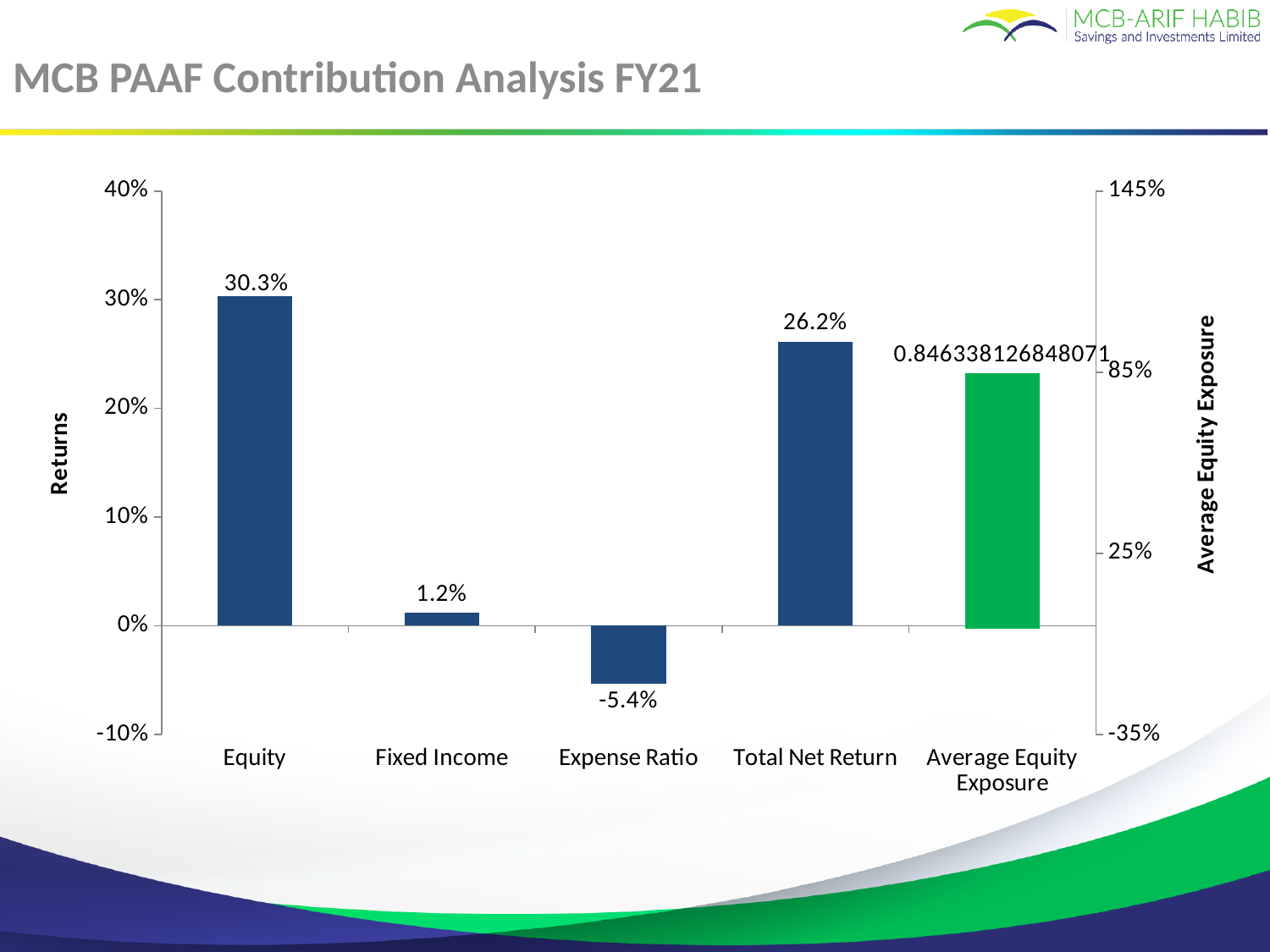
What data label is shown on the Average Equity Exposure bar? 0.846338126848071 Which category on the Returns axis has the highest value? Equity What is the value for Expense Ratio? -5.4% What is the difference between the Equity value and the Total Net Return value? 4.1% What is the value for Total Net Return? 26.2% What is the value for Fixed Income? 1.2% How many categories are shown on the x axis? 5 What is the value for Equity? 30.3% Which category has the lowest value? Expense Ratio What kind of chart is shown on the slide? Bar chart Which is larger, the value for Fixed Income or the value for Total Net Return? Total Net Return What is the title of the left vertical axis? Returns